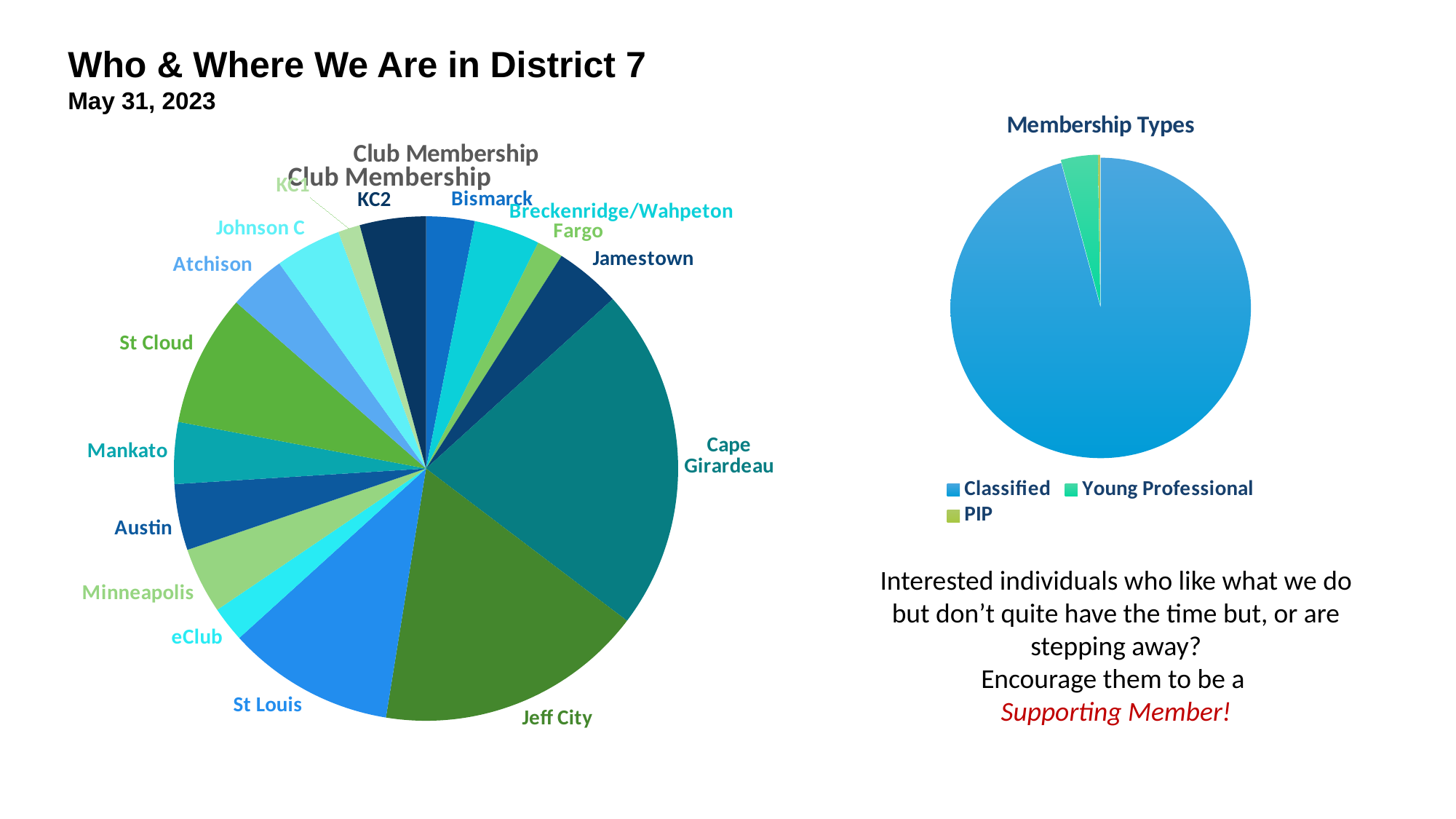
What kind of chart is the Membership Types chart on the right? pie chart What kind of chart is the Club Membership chart on the left? pie chart In the Membership Types chart, which slice is larger, Young Professional or PIP? Young Professional How many entries does the legend of the Membership Types chart list? 3 In the Membership Types chart, which membership type has the smallest slice? PIP In the Club Membership chart, which slice is larger, St Cloud or Atchison? St Cloud In the Club Membership chart, how many clubs are shown as slices? 16 In the Club Membership chart, which club has the largest slice? Cape Girardeau What is the title of the pie chart on the right side of the slide? Membership Types In the Club Membership chart, which slice is larger, Jeff City or Mankato? Jeff City In the Membership Types chart, which membership type has the largest slice? Classified